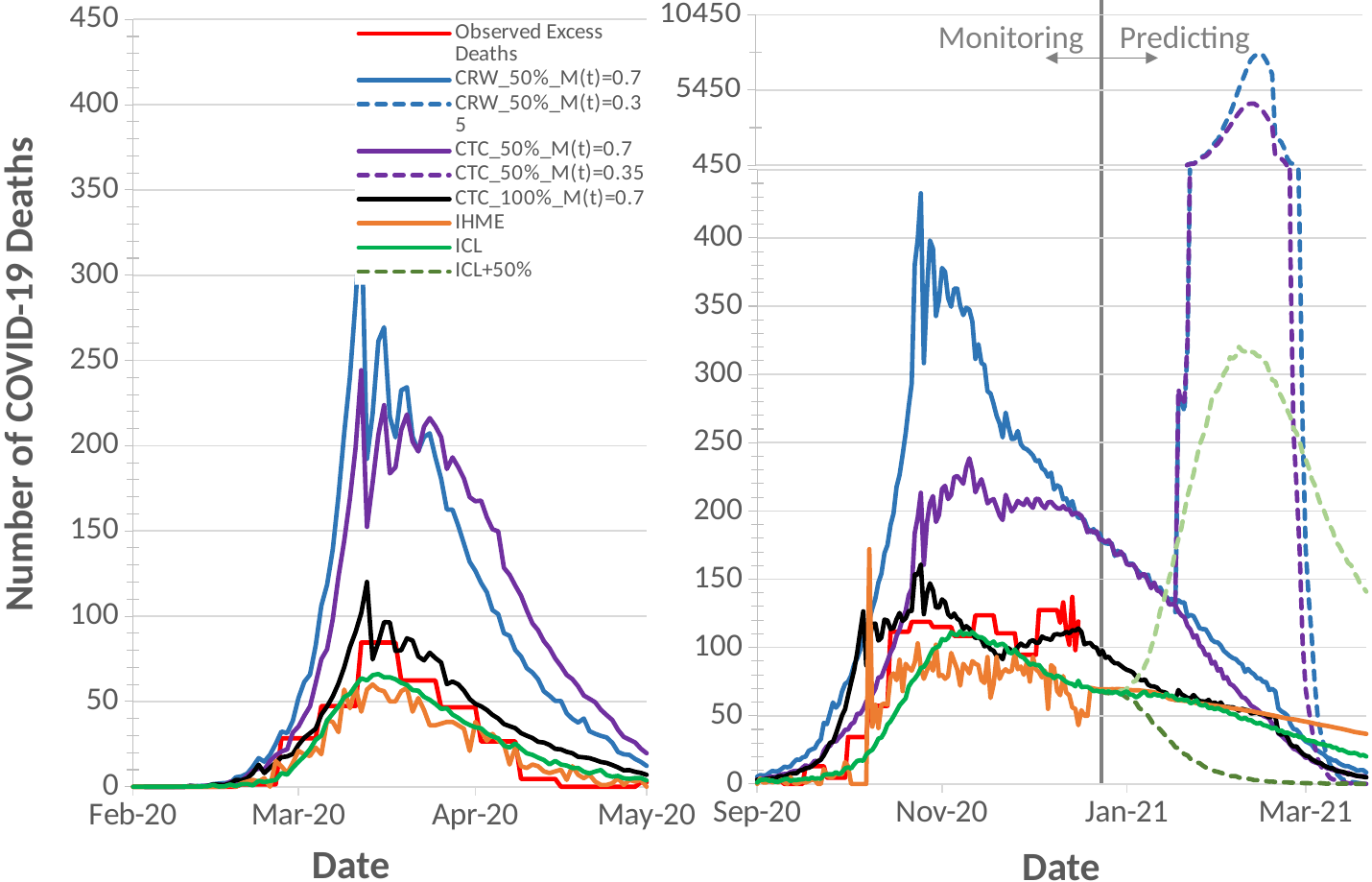
How many series does the legend list? 9 In the left chart, does the CRW_50%_M(t)=0.7 line rise or fall between Apr-20 and May-20? fall What is the y-axis title shared by the two charts? Number of COVID-19 Deaths In the left chart, is the peak value of IHME greater or less than 100? less In the right chart, is the peak value of CRW_50%_M(t)=0.7 greater or less than 400? greater In the left chart, which reaches a higher peak, CTC_50%_M(t)=0.7 or CTC_100%_M(t)=0.7? CTC_50%_M(t)=0.7 In the left chart, which series reaches the highest peak? CRW_50%_M(t)=0.7 In the left chart, is the peak value of CTC_100%_M(t)=0.7 greater or less than 100? greater In the right chart, what are the two phase labels shown on either side of the vertical divider line? Monitoring and Predicting What kind of chart is shown on the left of the slide? line chart